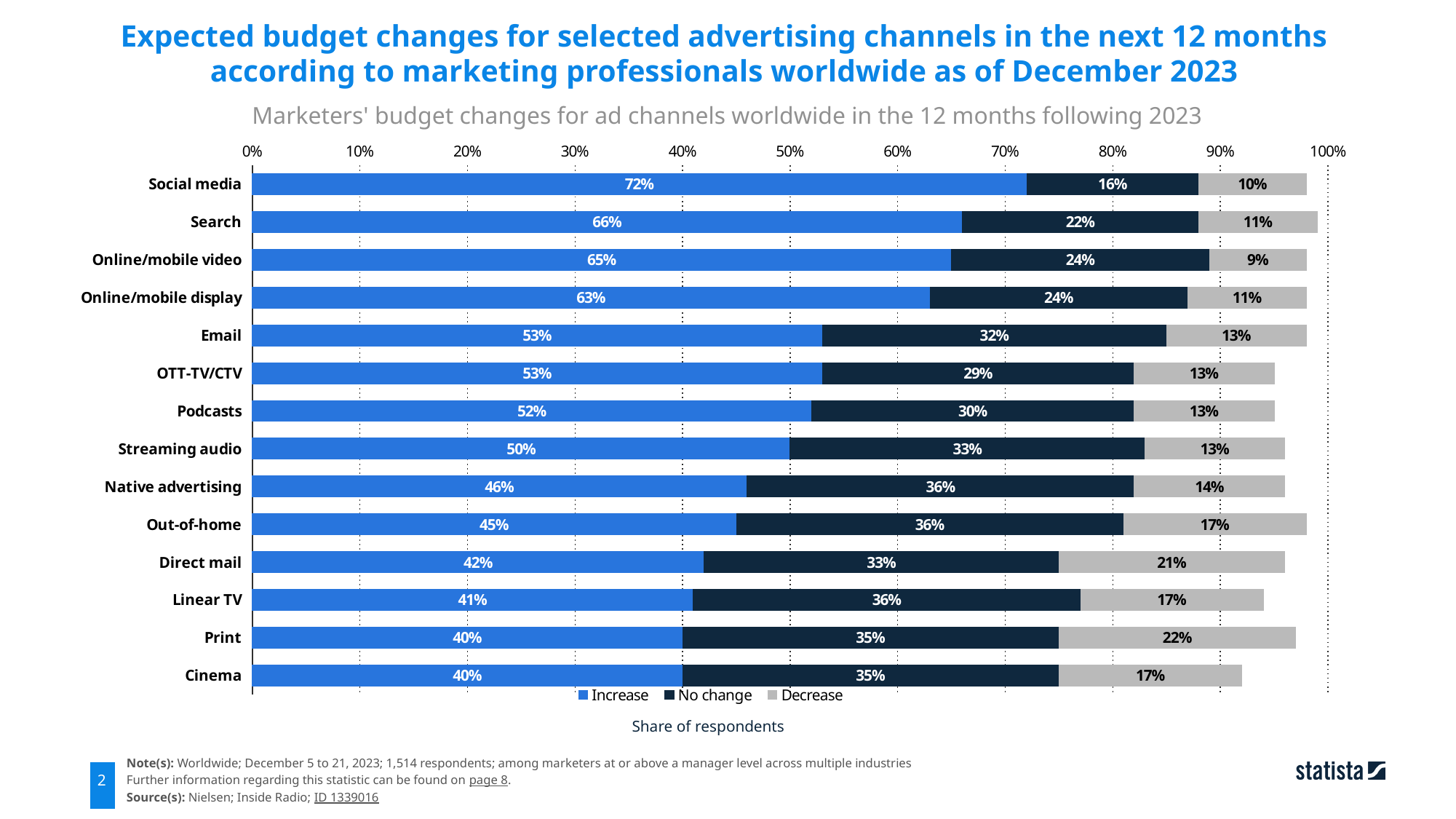
Which channel has the highest share of respondents expecting an increase? Social media What is the total of the three segments for the Podcasts bar? 95% What share of respondents expect no change in their Email budget? 32% How many series does the legend list? 3 Which channel has the lowest share of respondents expecting a decrease? Online/mobile video What share of respondents expect to decrease their Print budget? 22% Which has a larger Decrease share, Direct mail or Out-of-home? Direct mail What share of respondents expect to increase their Social media budget? 72% What is the label of the x axis? Share of respondents What is the difference between the Increase share for Search and the Increase share for Linear TV? 25% What kind of chart is shown on the slide? Stacked bar chart How many advertising channels are shown in the chart? 14